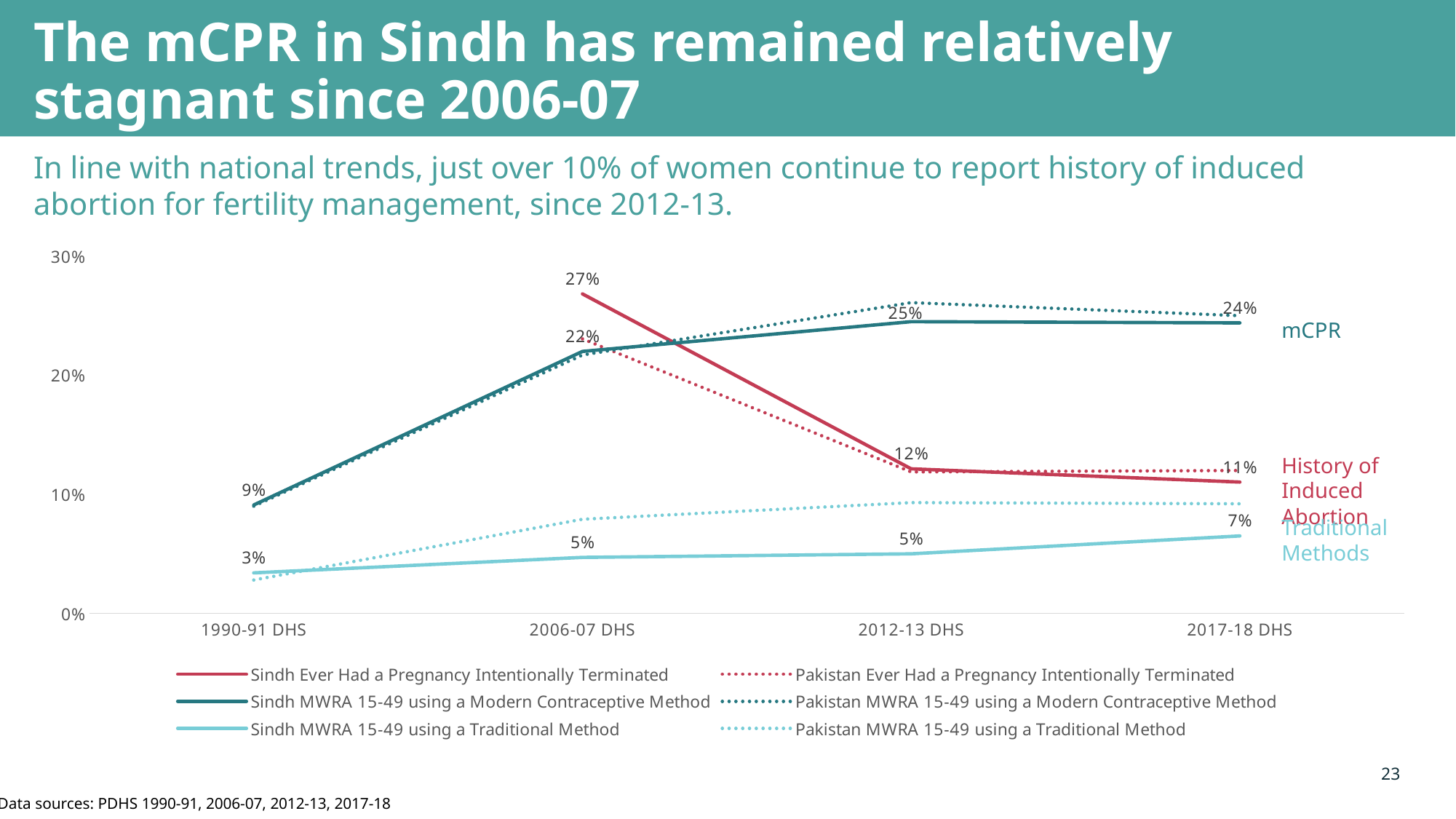
At which survey round is the Sindh MWRA 15-49 using a Traditional Method value lowest? 1990-91 DHS What is the difference between the Sindh Ever Had a Pregnancy Intentionally Terminated values at 2006-07 DHS and 2017-18 DHS? 16 percentage points At which survey round is the Sindh MWRA 15-49 using a Modern Contraceptive Method value highest? 2012-13 DHS At 2006-07 DHS, which is larger: Sindh Ever Had a Pregnancy Intentionally Terminated or Sindh MWRA 15-49 using a Modern Contraceptive Method? Sindh Ever Had a Pregnancy Intentionally Terminated How many series does the legend list? 6 What kind of chart is shown on the slide? line chart How many survey rounds are shown on the x axis? 4 By how many percentage points did Sindh MWRA 15-49 using a Modern Contraceptive Method increase from 1990-91 DHS to 2006-07 DHS? 13 percentage points What is the value for Sindh Ever Had a Pregnancy Intentionally Terminated at 2012-13 DHS? 12% What is the value for Sindh MWRA 15-49 using a Modern Contraceptive Method at 2006-07 DHS? 22% Is the value for Pakistan MWRA 15-49 using a Modern Contraceptive Method at 2012-13 DHS greater or less than 20%? greater What is the value for Sindh MWRA 15-49 using a Traditional Method at 2017-18 DHS? 7%